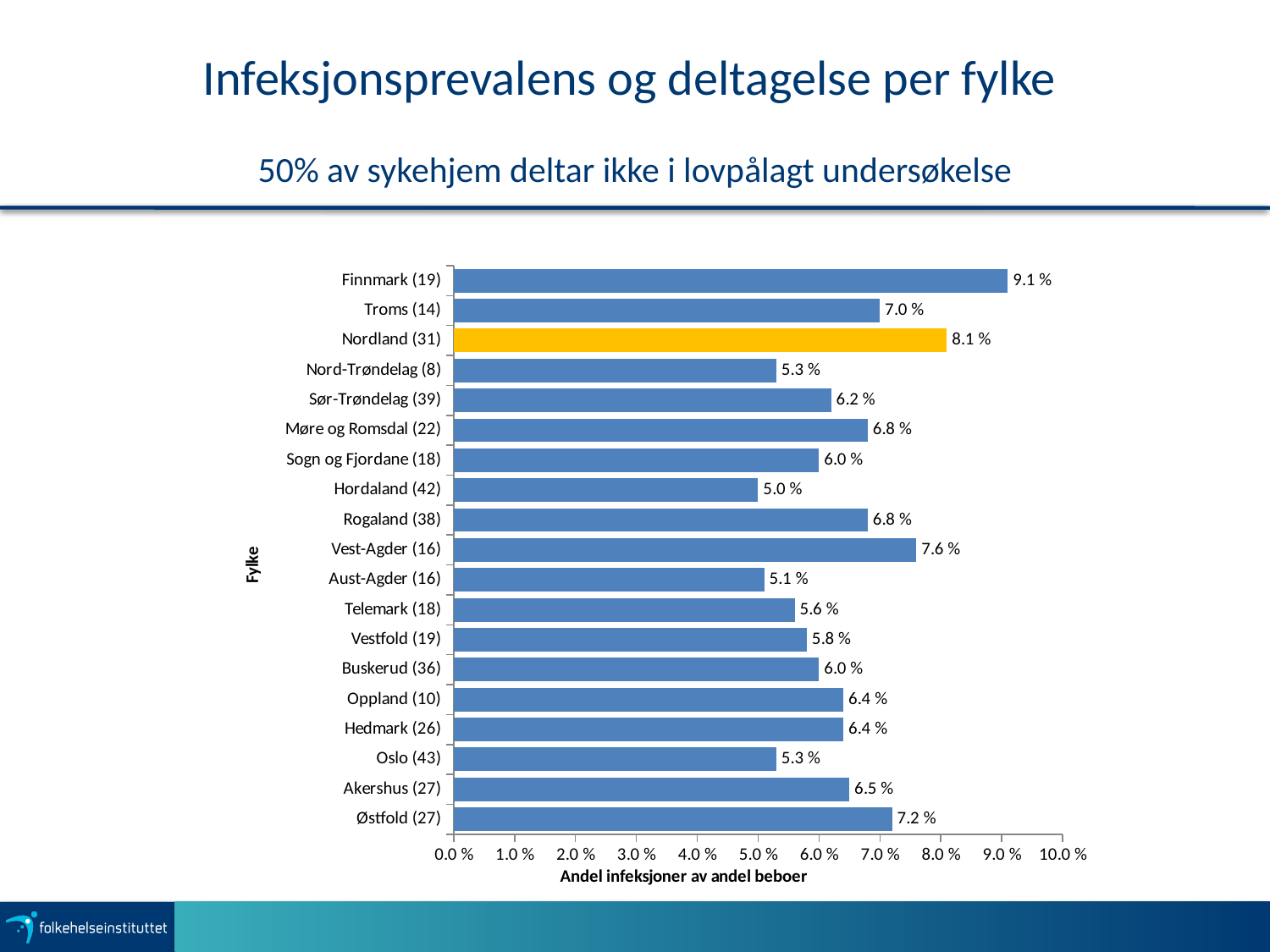
What is the x-axis title of the chart? Andel infeksjoner av andel beboer What kind of chart is shown on the slide? Bar chart Which fylke's bar is highlighted in a different colour (yellow) from the others? Nordland (31) How many fylker are shown in the chart? 19 What is the value for Nordland (31)? 8.1 % Which fylke has the lowest value? Hordaland (42) What is the value for Finnmark (19)? 9.1 % Which fylke has the highest value? Finnmark (19) Which is larger, the value for Vest-Agder (16) or Aust-Agder (16)? Vest-Agder (16) What is the value for Hordaland (42)? 5.0 % What is the value for Oslo (43)? 5.3 % What is the difference between the values for Finnmark (19) and Troms (14)? 2.1 %